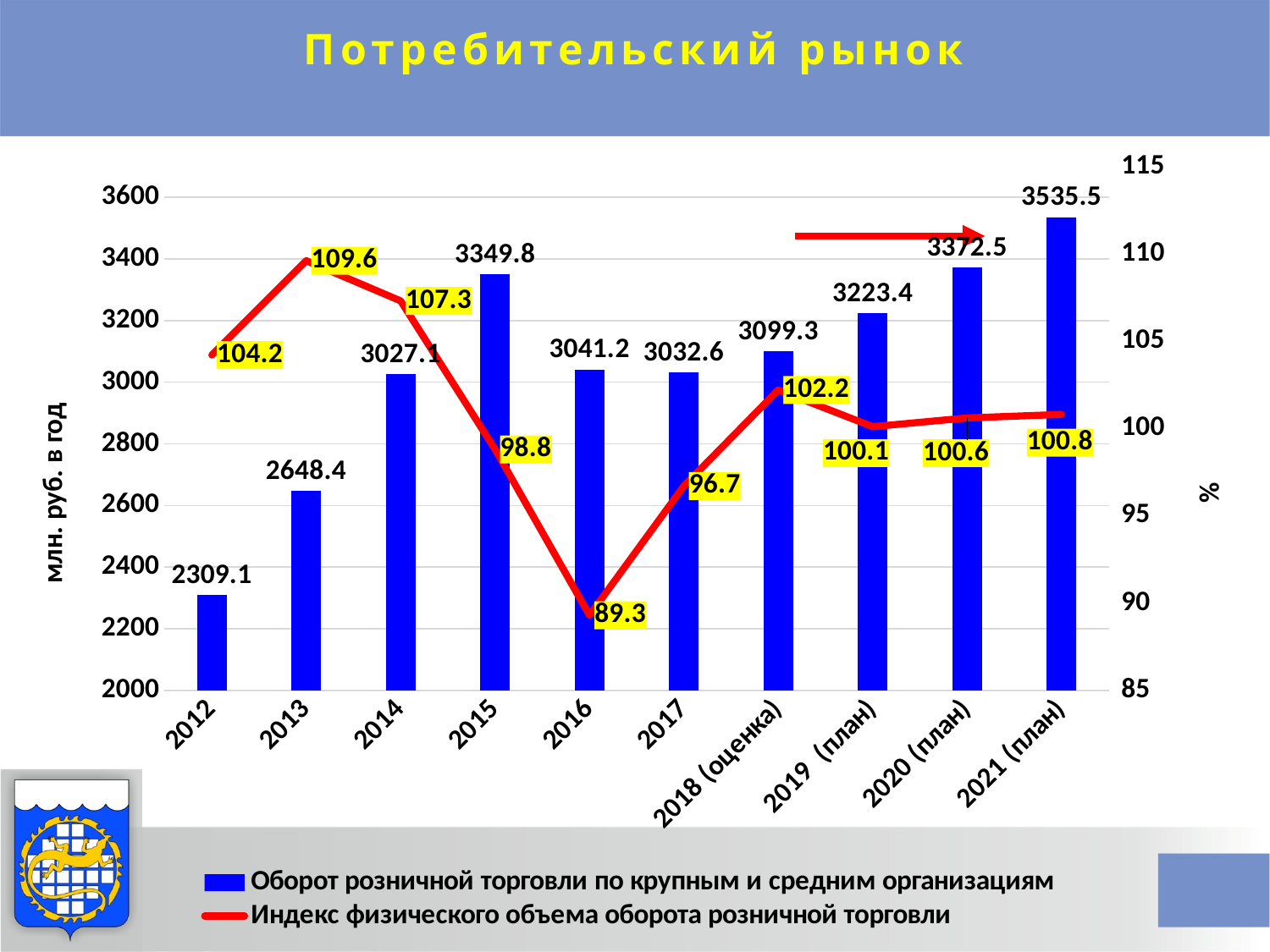
What is the value of the retail turnover bar (Оборот розничной торговли) for 2015? 3349.8 Do the retail turnover bars rise or fall from 2017 to 2021 (план)? Rise How many years (categories) are shown on the x axis? 10 Which is larger, the retail turnover bar for 2016 or for 2017? 2016 What is the difference between the highest and lowest values of the index line (2013 and 2016)? 20.3 What is the value of the index line (Индекс физического объема) for 2016? 89.3 Which year has the lowest retail turnover bar? 2012 Which year has the highest value of the index line (Индекс физического объема оборота розничной торговли)? 2013 What is the difference between the retail turnover for 2021 (план) and for 2012? 1226.4 What is the retail turnover value for 2021 (план)? 3535.5 What kind of chart is shown on the slide? Combined bar and line chart How many series does the legend list? 2